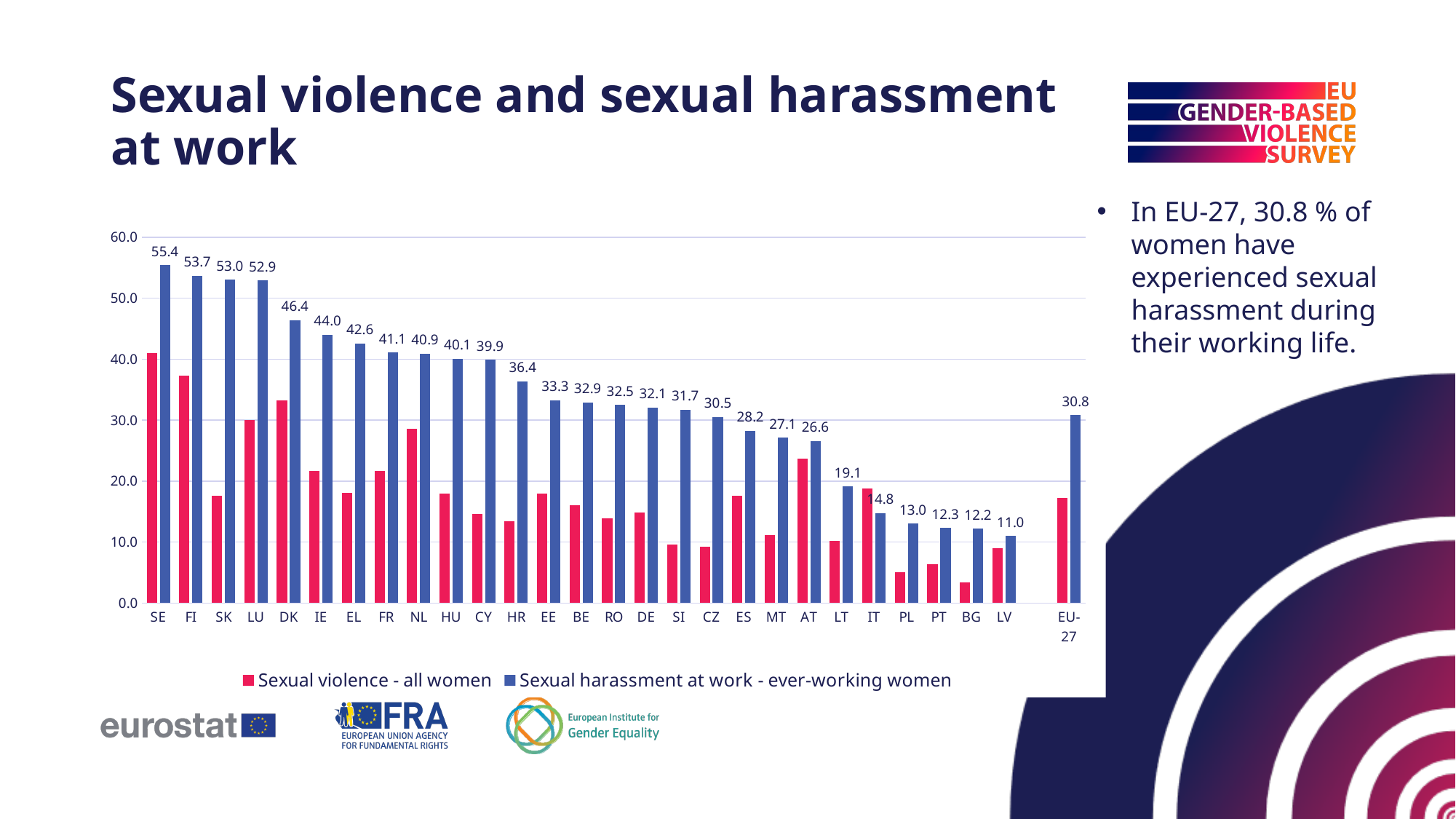
Which country has the highest value for sexual harassment at work? SE What is the value for sexual harassment at work for EU-27? 30.8 Is the sexual violence value for PL greater or less than 10.0? less How many categories are shown on the x axis? 28 How many series does the legend list? 2 What is the value for sexual harassment at work for SE? 55.4 What kind of chart is shown on the slide? Bar chart Is the sexual violence value for SE greater or less than 40.0? greater What is the difference between the sexual harassment at work values for SE and FI? 1.7 What is the value for sexual harassment at work for HR? 36.4 Which country has the lowest value for sexual harassment at work? LV Which is larger, the sexual harassment at work value for DK or for IE? DK